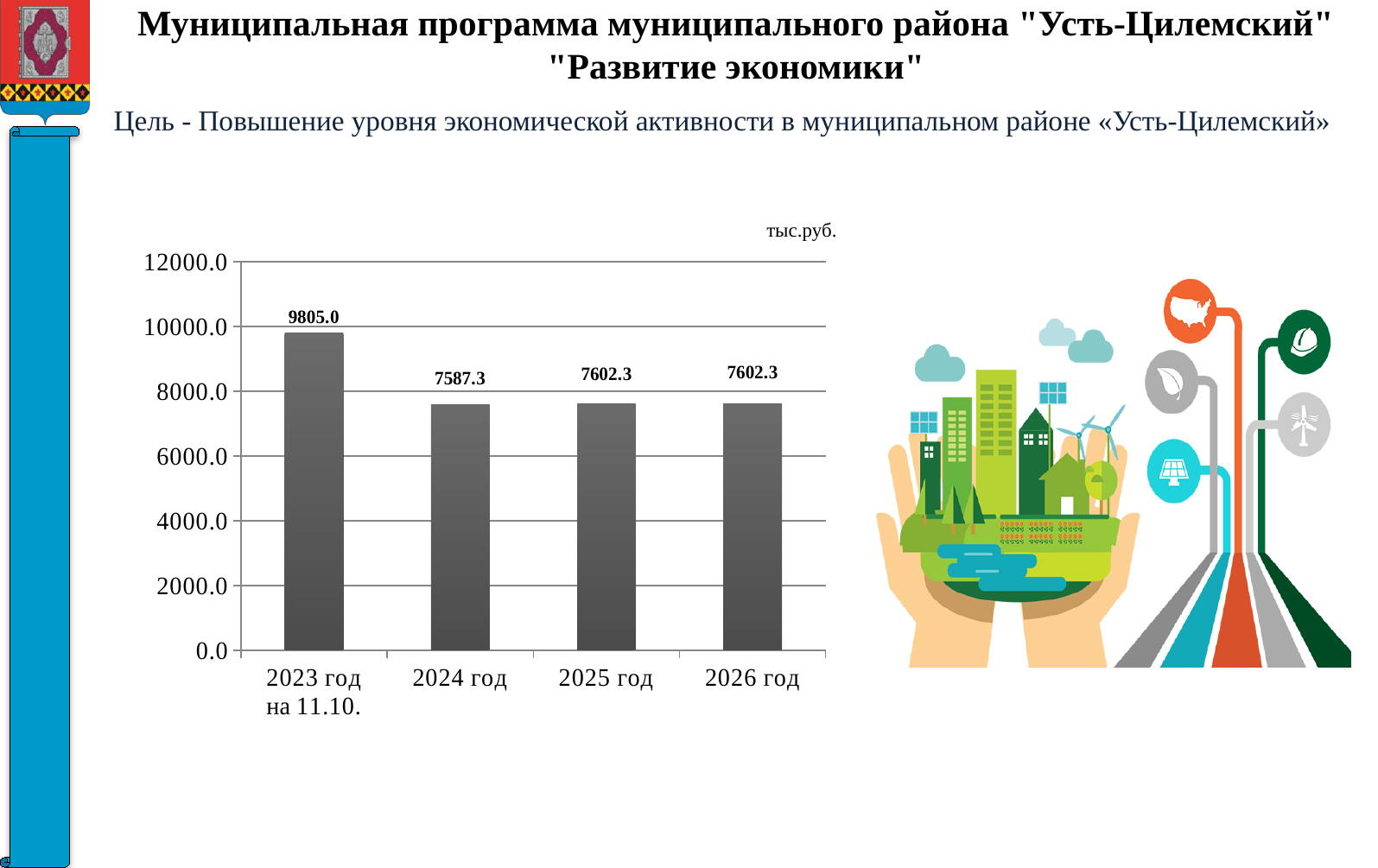
Is the value for 2024 год greater or less than 8000.0? less What is the value for 2023 год на 11.10.? 9805.0 How many years are shown on the x axis? 4 Which year has the lowest value? 2024 год What is the difference between the values for 2023 год на 11.10. and 2024 год? 2217.7 Which year has the highest value? 2023 год на 11.10. What is the value for 2024 год? 7587.3 What unit is indicated above the chart? тыс.руб. Which is larger, the value for 2023 год на 11.10. or the value for 2025 год? 2023 год на 11.10. What is the value for 2026 год? 7602.3 What is the difference between the values for 2025 год and 2024 год? 15.0 What kind of chart is shown on the slide? bar chart